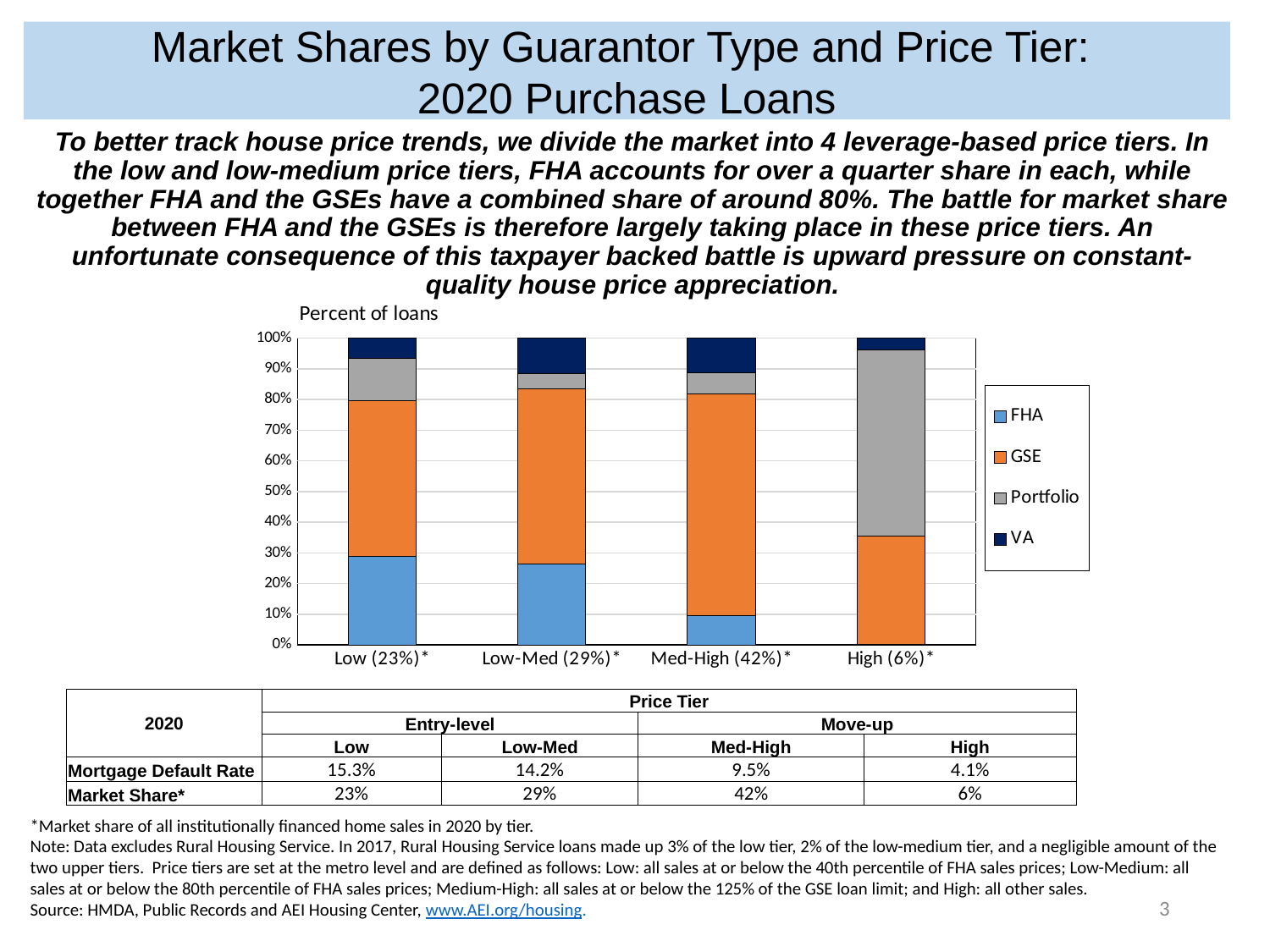
Does the FHA share rise or fall moving from the Low tier to the High tier along the x axis? Fall Is the Portfolio share in the High (6%)* tier greater or less than 50%? greater Is the GSE segment larger in the Med-High (42%)* tier or the High (6%)* tier? Med-High (42%)* Which price tier has the smallest FHA segment? High (6%)* Is the FHA share in the Low (23%)* tier greater or less than 20%? greater What kind of chart is shown on the slide? Stacked bar chart Which series are listed in the chart legend? FHA, GSE, Portfolio, VA How many price tier categories are plotted on the x axis of the chart? 4 Which price tier has the largest Portfolio segment? High (6%)* How many series does the chart legend list? 4 Is the FHA share in the Med-High (42%)* tier greater or less than 20%? less What is the label shown above the vertical axis of the chart? Percent of loans